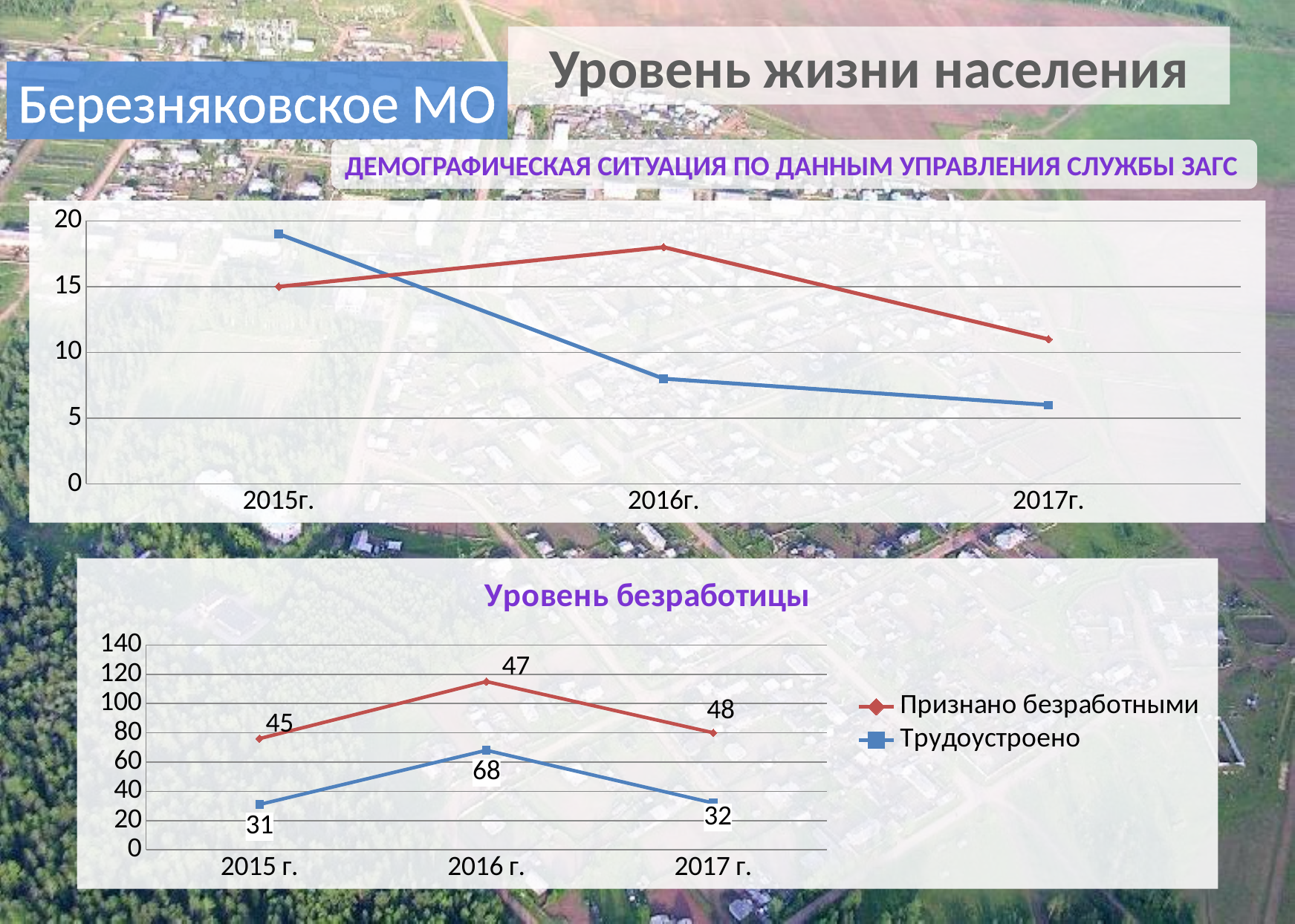
In the "Уровень безработицы" chart, what is the difference between the Трудоустроено values for 2016 г. and 2015 г.? 37 What kind of chart is the "Уровень безработицы" chart? line chart In the "Уровень безработицы" chart, in which year is the Трудоустроено value highest? 2016 г. In the "Уровень безработицы" chart, what is the value for Трудоустроено in 2017 г.? 32 In the top chart (ДЕМОГРАФИЧЕСКАЯ СИТУАЦИЯ ПО ДАННЫМ УПРАВЛЕНИЯ СЛУЖБЫ ЗАГС), does the blue line rise or fall from 2015г. to 2017г.? fall In the "Уровень безработицы" chart, what is the value for Трудоустроено in 2016 г.? 68 In the top chart (ДЕМОГРАФИЧЕСКАЯ СИТУАЦИЯ ПО ДАННЫМ УПРАВЛЕНИЯ СЛУЖБЫ ЗАГС), is the value of the blue line for 2015г. greater or less than 15? greater In the top chart (ДЕМОГРАФИЧЕСКАЯ СИТУАЦИЯ ПО ДАННЫМ УПРАВЛЕНИЯ СЛУЖБЫ ЗАГС), is the value of the red line for 2017г. greater or less than 15? less How many years are shown on the x axis of the "Уровень безработицы" chart? 3 In the "Уровень безработицы" chart, what is the value for Признано безработными in 2015 г.? 45 In the top chart (ДЕМОГРАФИЧЕСКАЯ СИТУАЦИЯ ПО ДАННЫМ УПРАВЛЕНИЯ СЛУЖБЫ ЗАГС), which line is higher in 2016г., the red line or the blue line? the red line How many series does the legend of the "Уровень безработицы" chart list? 2